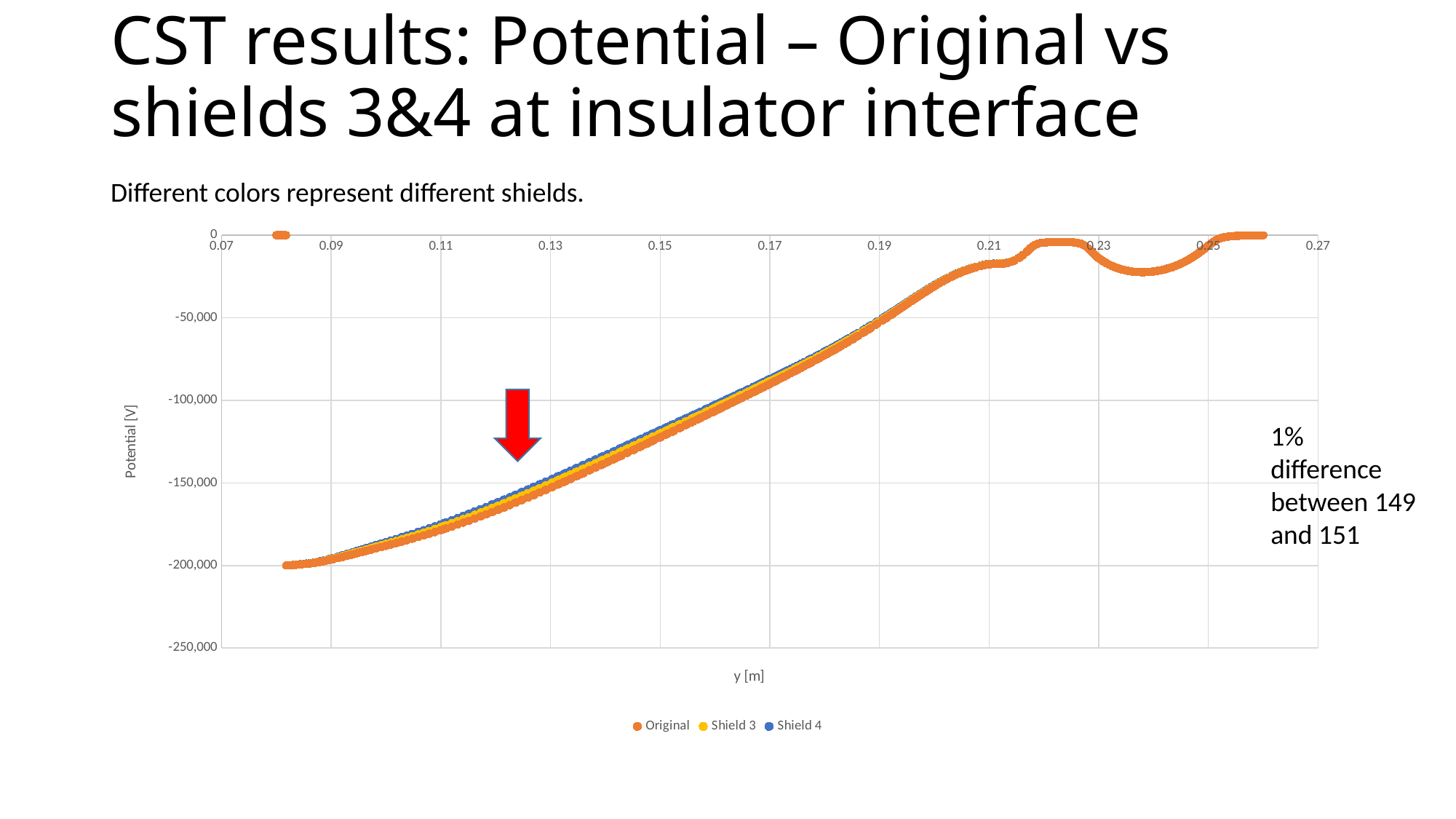
What is the lowest value shown on the vertical axis? -250,000 Do the potential values rise or fall as y increases from 0.08 m to 0.21 m? Rise Which series is drawn in blue? Shield 4 Is the potential at y = 0.21 m above or below -50,000 V? Above Is the potential at y = 0.11 m above or below -150,000 V? Below What are the names of the series in the legend? Original, Shield 3, Shield 4 What kind of chart is shown on the slide? Scatter chart Is the potential at y = 0.09 m above or below -150,000 V? Below How many series does the legend list? 3